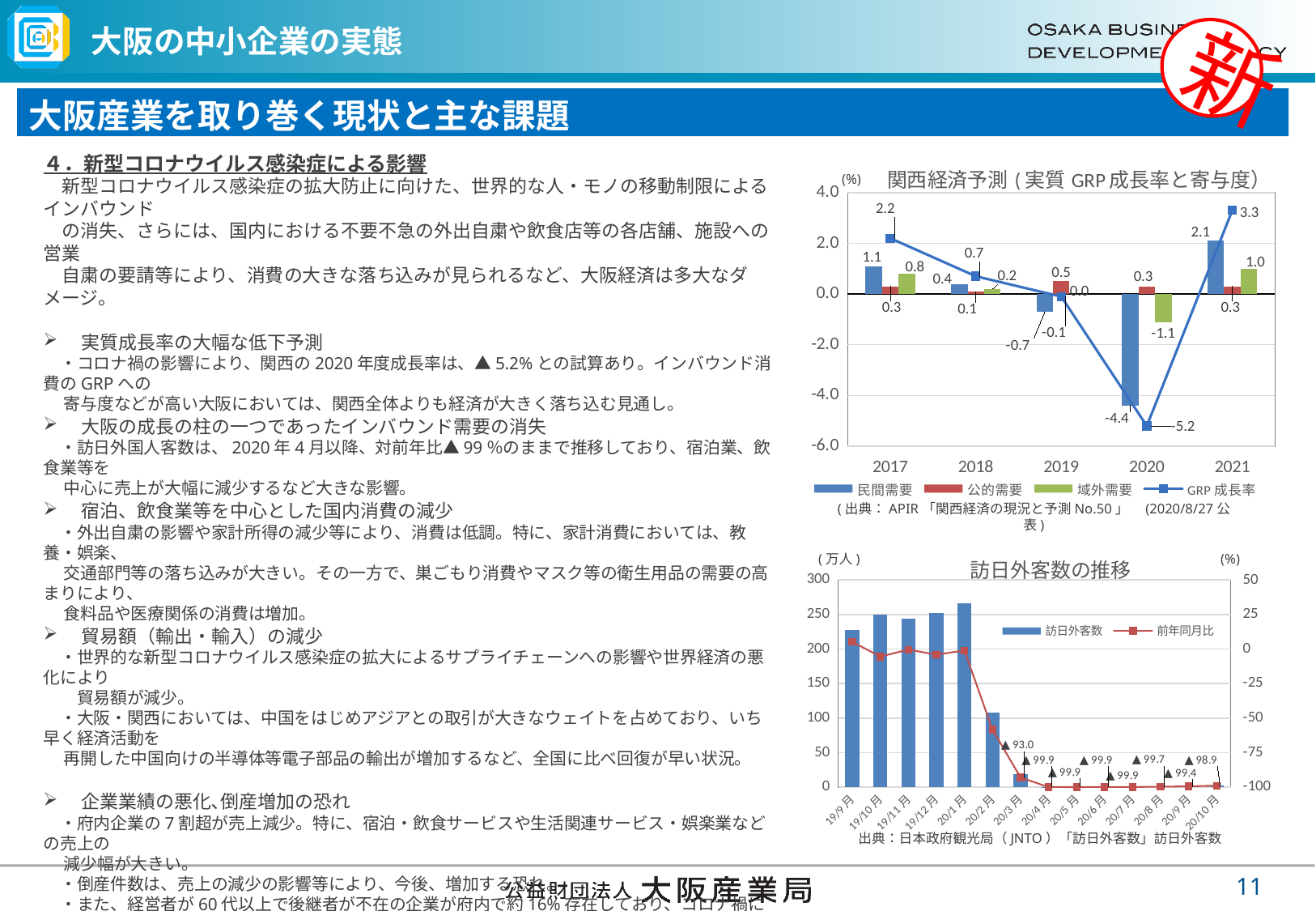
In the 関西経済予測 chart, which year has the highest GRP成長率? 2021 In the 訪日外客数の推移 chart, do the 訪日外客数 bars rise or fall from 20/1月 to 20/4月? fall In the 関西経済予測 chart, what is the difference between the GRP成長率 for 2021 and 2020? 8.5 In the 関西経済予測 chart, is the 民間需要 value larger in 2017 or 2018? 2017 In the 関西経済予測 chart, what is the GRP成長率 value for 2020? -5.2 How many series does the legend of the 関西経済予測 chart list? 4 How many months are shown on the x axis of the 訪日外客数の推移 chart? 14 How many years are shown on the x axis of the 関西経済予測 chart? 5 In the 関西経済予測 chart, which year has the lowest GRP成長率? 2020 In the 訪日外客数の推移 chart, is the 訪日外客数 value for 20/1月 greater or less than 250? greater In the 関西経済予測 chart, what is the 民間需要 value for 2021? 2.1 In the 訪日外客数の推移 chart, what is the 前年同月比 value for 20/3月? ▲93.0